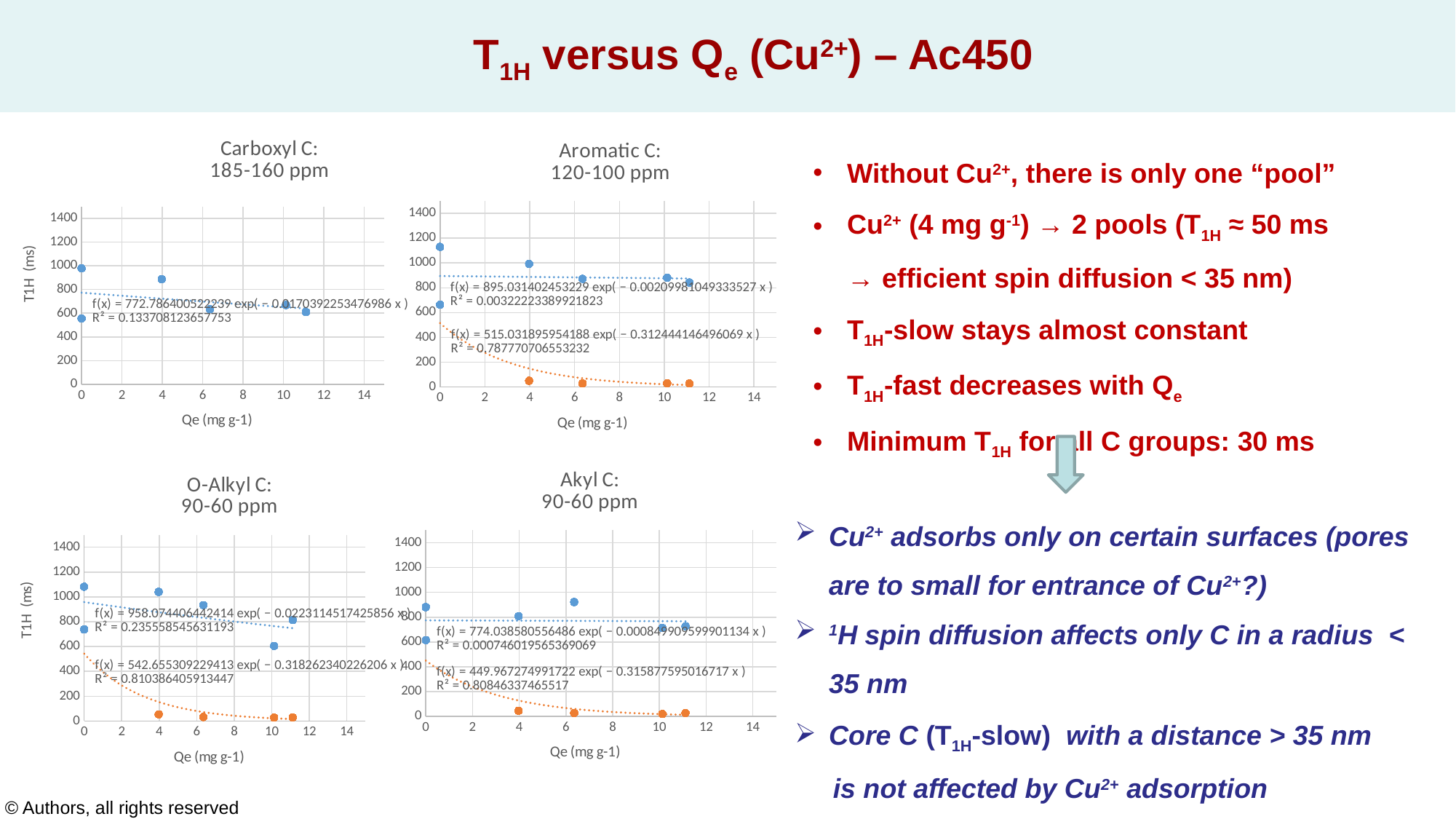
In the Aromatic C: 120-100 ppm chart, is the orange point at Qe = 4 greater or less than 200? less What is the x-axis label of the Carboxyl C: 185-160 ppm chart? Qe (mg g-1) What R² value is printed for the fit in the Carboxyl C: 185-160 ppm chart? 0.133708123657753 In the Aromatic C: 120-100 ppm chart, at Qe = 4, which is larger, the blue point or the orange point? the blue point In the O-Alkyl C: 90-60 ppm chart, is the blue point at Qe = 10 greater or less than 800? less In the Akyl C: 90-60 ppm chart, is the orange point at Qe = 10 greater or less than 200? less In the Aromatic C: 120-100 ppm chart, do the orange points rise or fall as Qe increases? fall In the O-Alkyl C: 90-60 ppm chart, do the orange points rise or fall as Qe increases? fall What type of chart is the Carboxyl C: 185-160 ppm chart? scatter chart